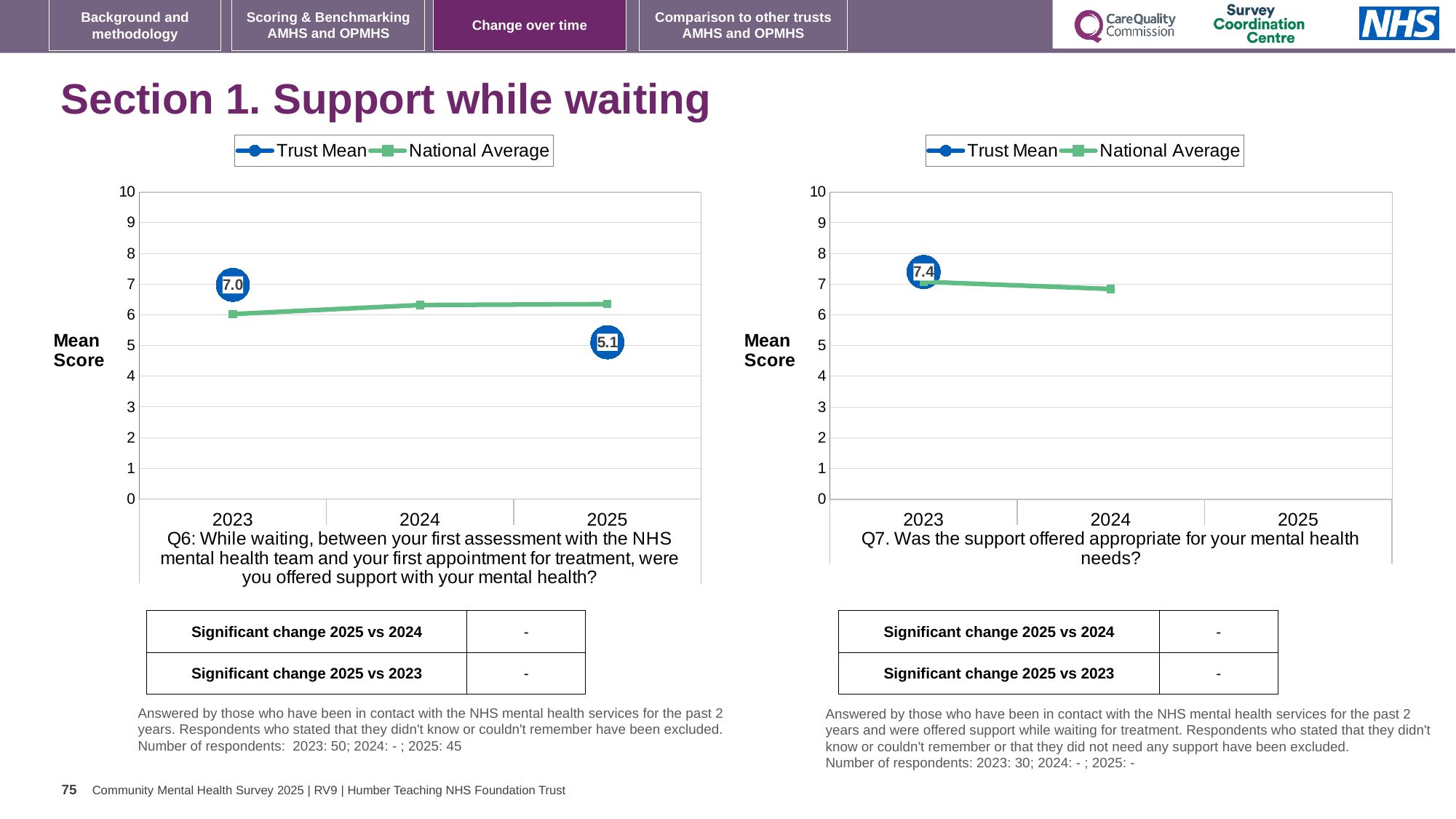
On the left chart (Q6), does the Trust Mean rise or fall from 2023 to 2025? fall How many series does the legend of the left chart (Q6) list? 2 On the left chart (Q6), is the National Average for 2023 greater or less than 7? less How many years are shown on the x axis of the right chart (Q7)? 3 On the left chart (Q6), which is larger in 2025: the Trust Mean or the National Average? National Average On the left chart (Q6), what is the Trust Mean for 2023? 7.0 On the left chart (Q6), what is the Trust Mean for 2025? 5.1 On the right chart (Q7), is the National Average for 2024 greater or less than 6? greater On the left chart (Q6), by how much did the Trust Mean fall from 2023 to 2025? 1.9 On the right chart (Q7), what is the Trust Mean for 2023? 7.4 What is the label of the y axis on the left chart (Q6)? Mean Score What kind of chart is the right chart (Q7)? line chart